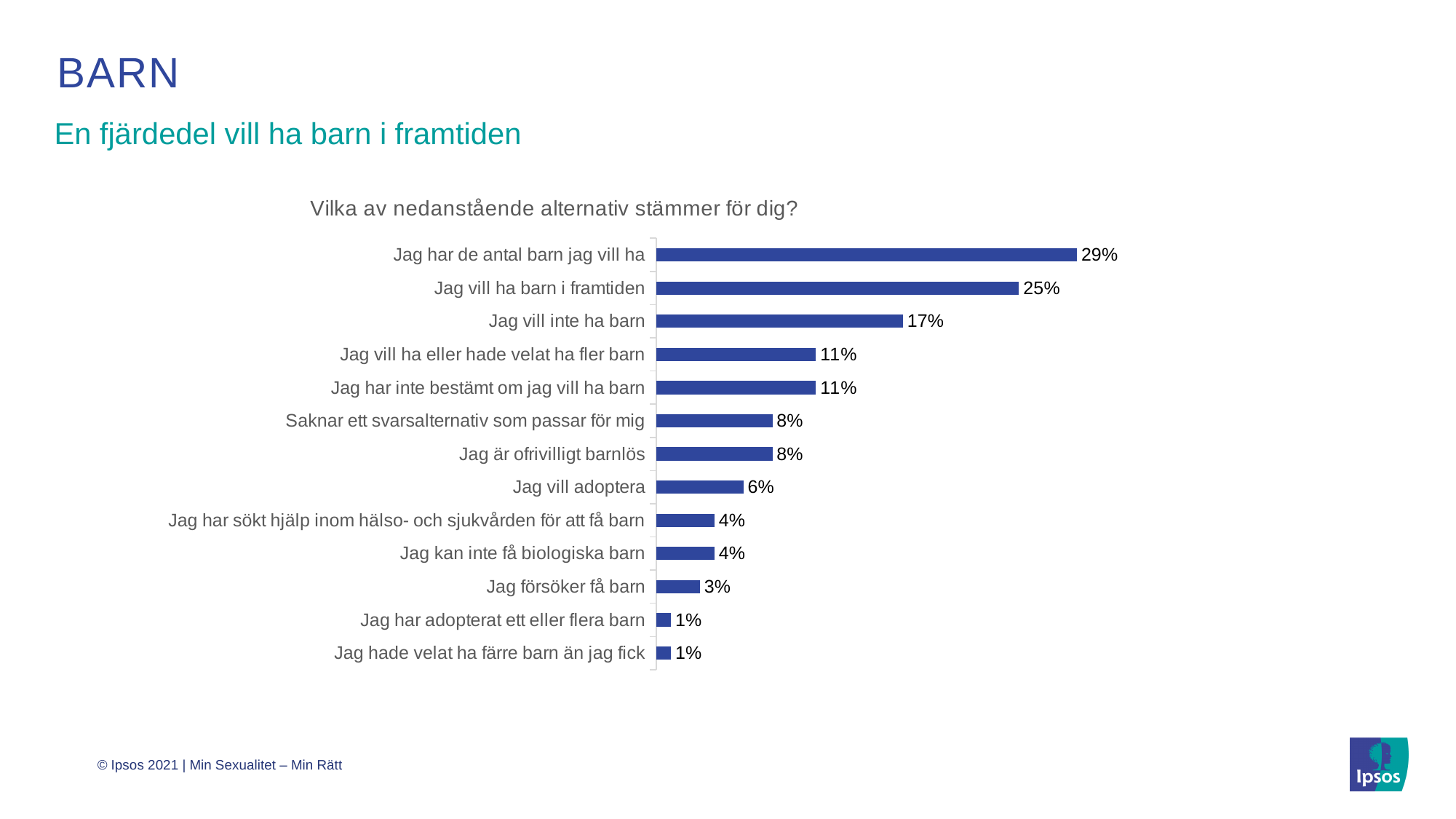
What is the value for "Jag vill ha barn i framtiden"? 25% What is the value for "Jag vill adoptera"? 6% How many categories are shown in the chart? 13 What is the difference between "Jag har de antal barn jag vill ha" and "Jag vill ha barn i framtiden"? 4% What is the value for "Jag har adopterat ett eller flera barn"? 1% What is the difference between "Jag vill inte ha barn" and "Jag är ofrivilligt barnlös"? 9% What kind of chart is shown on the slide? Bar chart Which category has the highest value? Jag har de antal barn jag vill ha What is the value for "Jag försöker få barn"? 3% What is the value for "Jag vill inte ha barn"? 17% What is the title of the chart? Vilka av nedanstående alternativ stämmer för dig? Which is larger, "Jag vill inte ha barn" or "Jag har inte bestämt om jag vill ha barn"? Jag vill inte ha barn